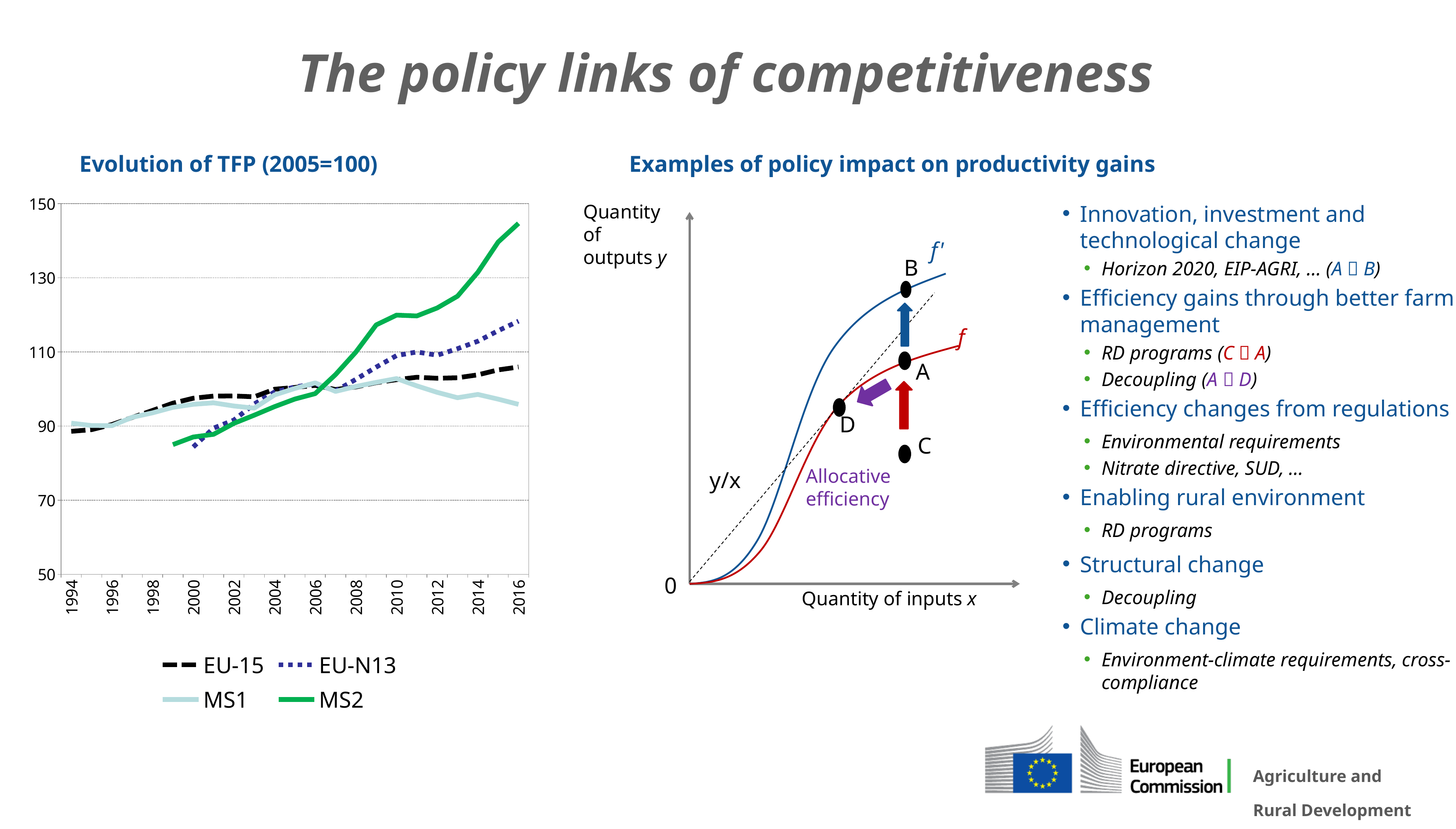
What kind of chart is 'Evolution of TFP (2005=100)'? line chart In the 'Evolution of TFP (2005=100)' chart, is the value for MS1 in 2016 greater or less than 100? less In the 'Evolution of TFP (2005=100)' chart, which series has the highest value in 2016? MS2 In the 'Evolution of TFP (2005=100)' chart, does the MS2 series generally rise or fall from 2000 to 2016? rise In the 'Evolution of TFP (2005=100)' chart, is the value for MS2 in 2016 greater or less than 130? greater In the 'Evolution of TFP (2005=100)' chart, is the value for EU-N13 in 2016 greater or less than 110? greater In the 'Evolution of TFP (2005=100)' chart, which is larger in 2016: MS2 or EU-15? MS2 How many series does the legend of the 'Evolution of TFP (2005=100)' chart list? 4 In the 'Evolution of TFP (2005=100)' chart, which series has the lowest value in 2016? MS1 In the 'Evolution of TFP (2005=100)' chart, does the MS1 series rise or fall from 2010 to 2016? fall In the 'Evolution of TFP (2005=100)' chart, which series is drawn as a solid green line? MS2